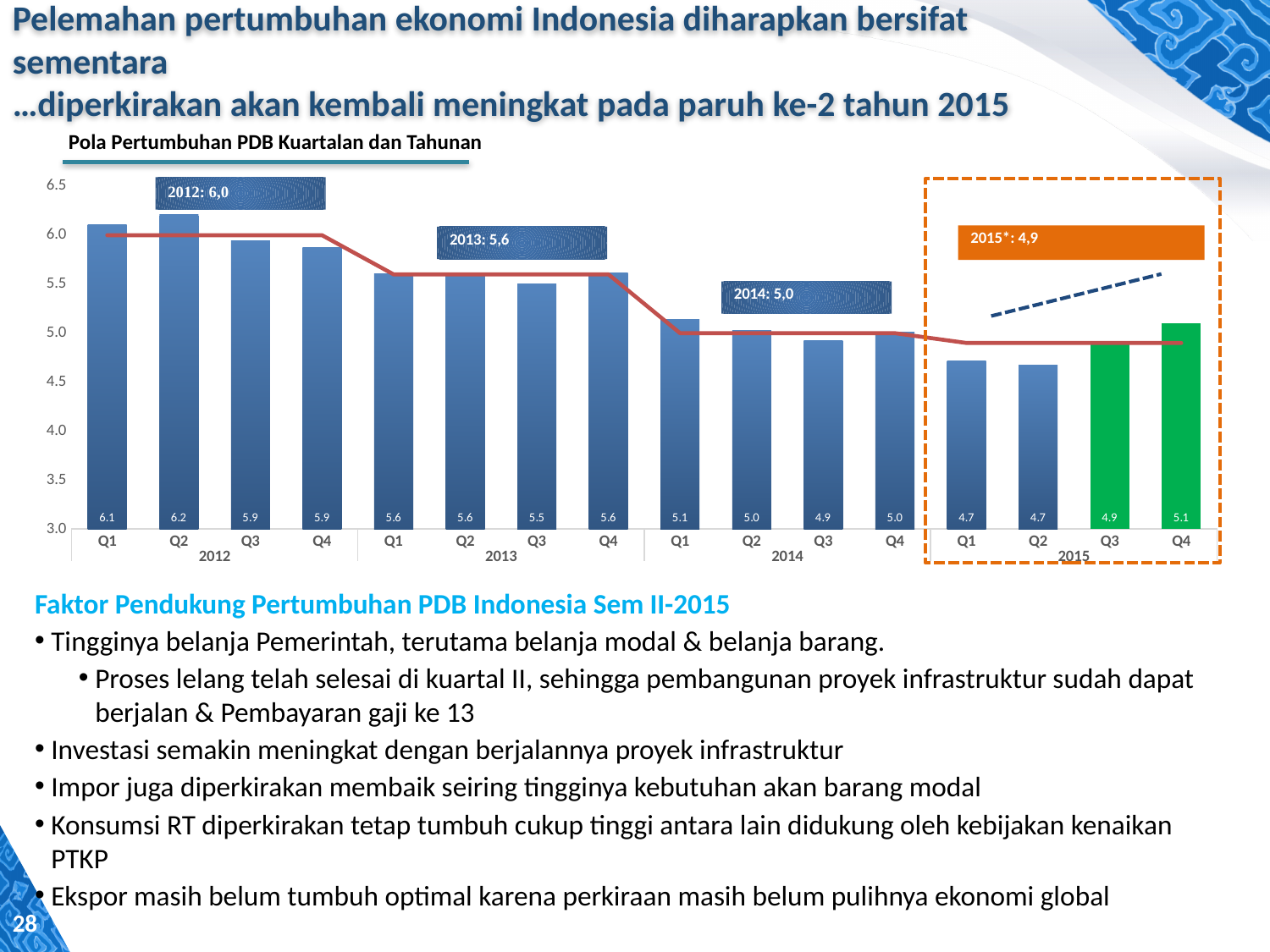
What is the title of the chart? Pola Pertumbuhan PDB Kuartalan dan Tahunan What is the value for Q4 2015? 5.1 Which quarter has the highest value? Q2 2012 Which is larger, the value for Q1 2014 or the value for Q3 2015? Q1 2014 Is the value for Q3 2013 greater or less than 5.0? greater What annual growth figure is shown in the label for 2013? 5,6 What is the difference between the values for Q2 2012 and Q1 2015? 1.5 Do the quarterly values rise or fall from Q1 2012 to Q2 2015? fall What is the value for Q2 2012? 6.2 What kind of chart is shown on the slide? combination bar and line chart What is the value for Q1 2015? 4.7 How many quarterly bars are plotted in the chart? 16